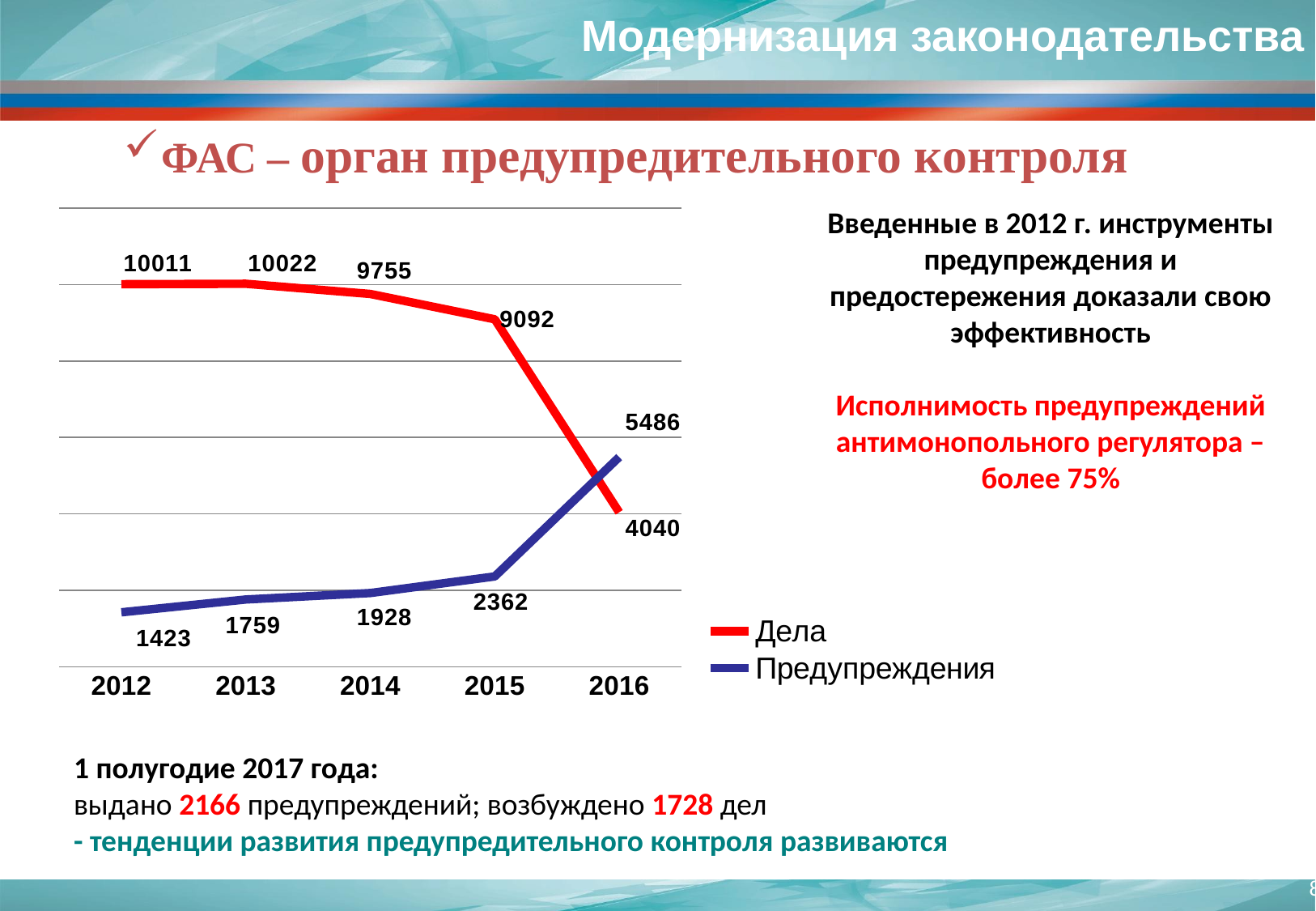
What type of chart is shown on the slide? line chart How many series does the legend list? 2 What is the value for Дела in 2016? 4040 Does the value for Предупреждения rise or fall from 2012 to 2016? rise What is the difference between Дела in 2015 and Дела in 2016? 5052 In which year is the value for Предупреждения lowest? 2012 What is the value for Дела in 2012? 10011 In which year is the value for Дела highest? 2013 How many years are shown on the x axis? 5 What is the value for Предупреждения in 2014? 1928 What is the value for Предупреждения in 2016? 5486 Which is larger in 2016, Дела or Предупреждения? Предупреждения